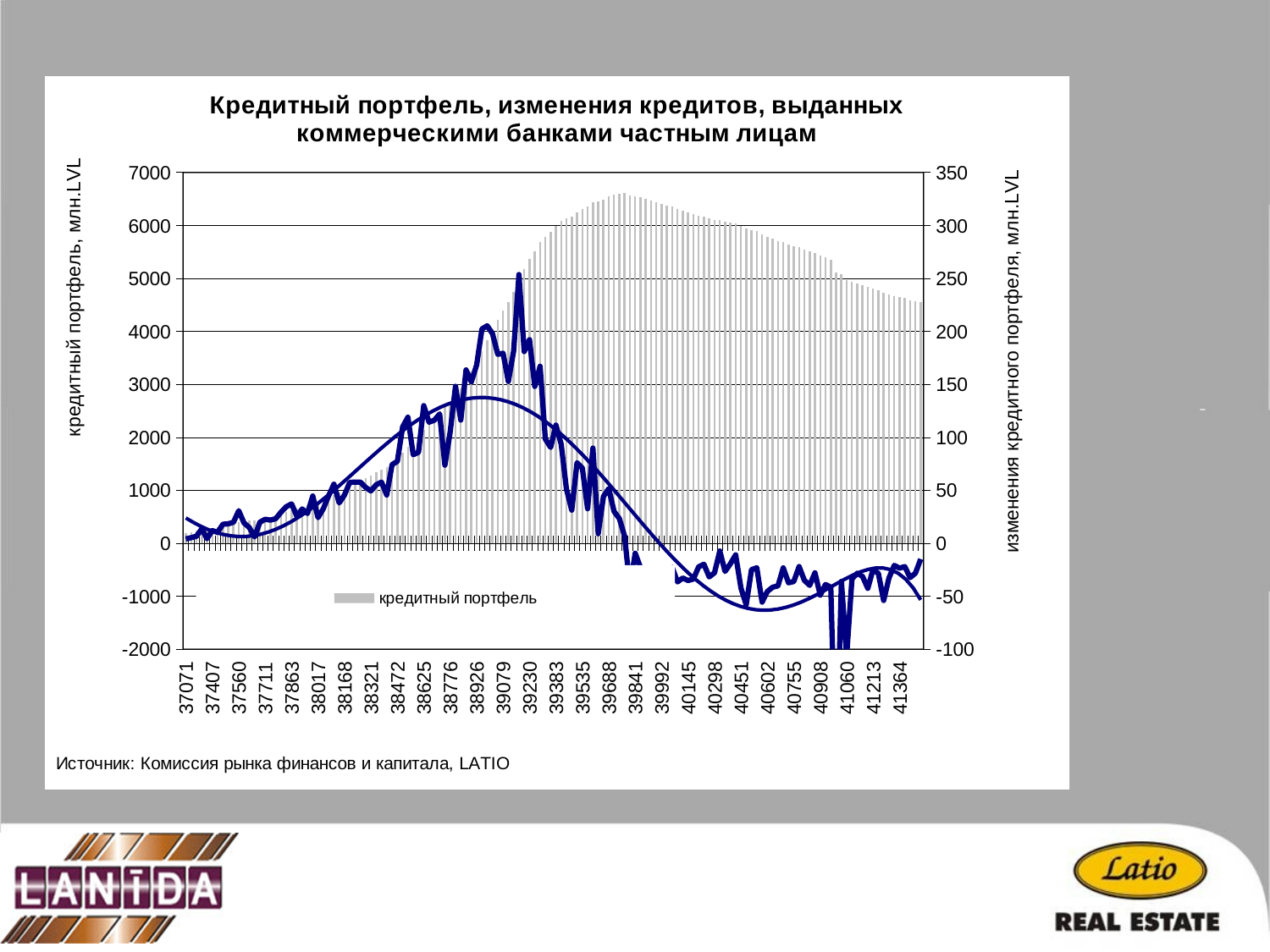
Is the credit portfolio bar at 39230 greater or less than 5000 on the left axis? greater How many labels are shown on the x axis? 28 Which is larger, the credit portfolio bar at 38017 or at 40602? 40602 Is the credit portfolio bar at 39841 greater or less than 6000 on the left axis? greater What kind of chart is shown on the slide? A combined bar and line chart Do the credit portfolio bars rise or fall from 39841 to 41364? fall How many series does the legend list? 1 What series name is shown in the chart legend? кредитный портфель Which x-axis label has the lowest credit portfolio bar? 37071 Is the credit portfolio bar at 41364 greater or less than 4000 on the left axis? greater What is the title of the chart? Кредитный портфель, изменения кредитов, выданных коммерческими банками частным лицам